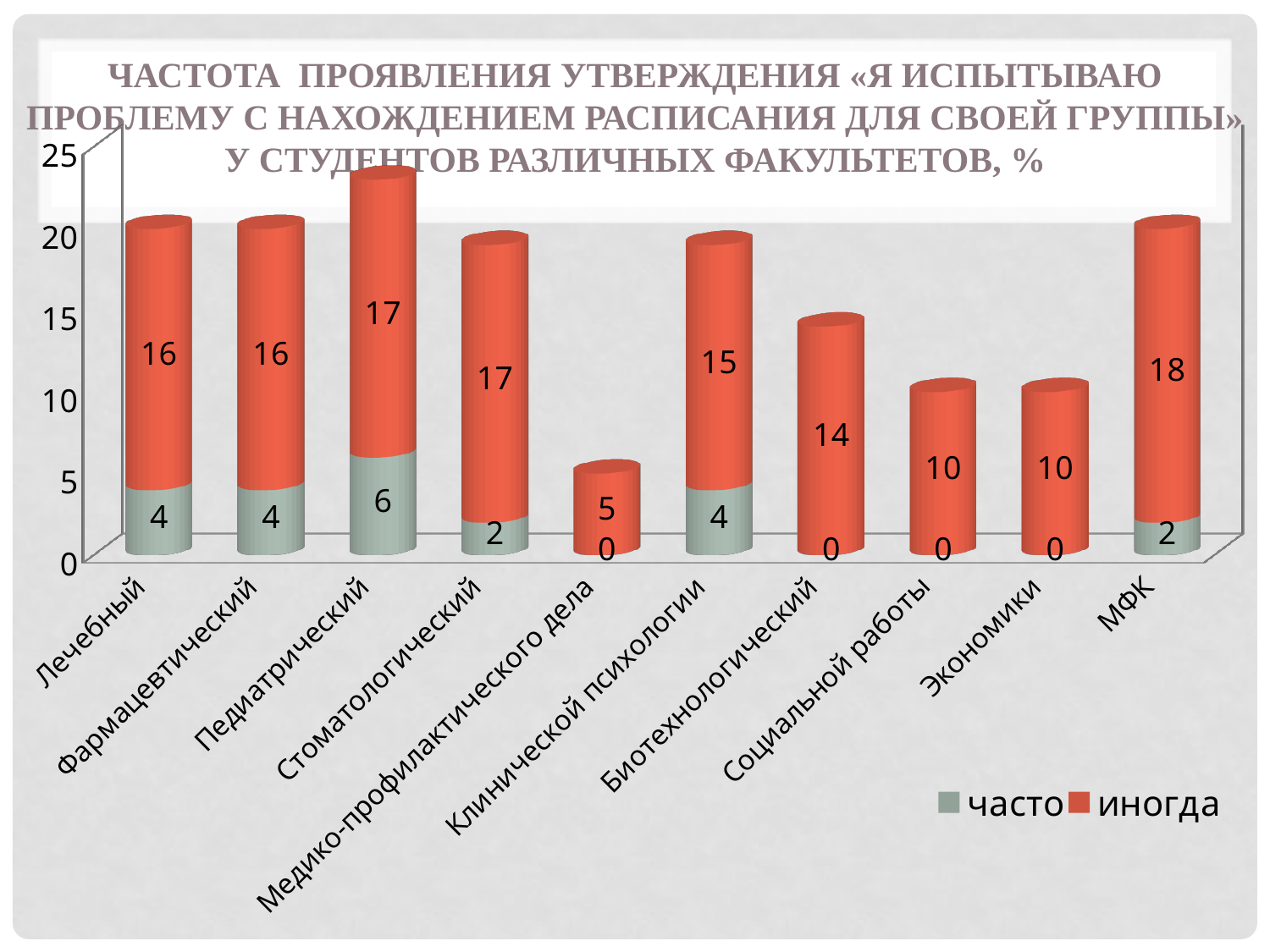
Which series is shown in red in the legend? иногда What is the value of the "часто" series for Стоматологический? 2 What is the difference between the "иногда" values for МФК and Экономики? 8 How many series does the legend list? 2 How many faculties (categories) are shown on the x axis? 10 What type of chart is shown on the slide? bar chart What is the value of the "иногда" series for Педиатрический? 17 Which faculty has the lowest value for the "иногда" series? Медико-профилактического дела Which faculty has the highest value for the "часто" series? Педиатрический What is the value of the "иногда" series for Биотехнологический? 14 Which is larger: the "иногда" value for Клинической психологии or for Социальной работы? Клинической психологии What is the total of the stacked bar for Педиатрический? 23